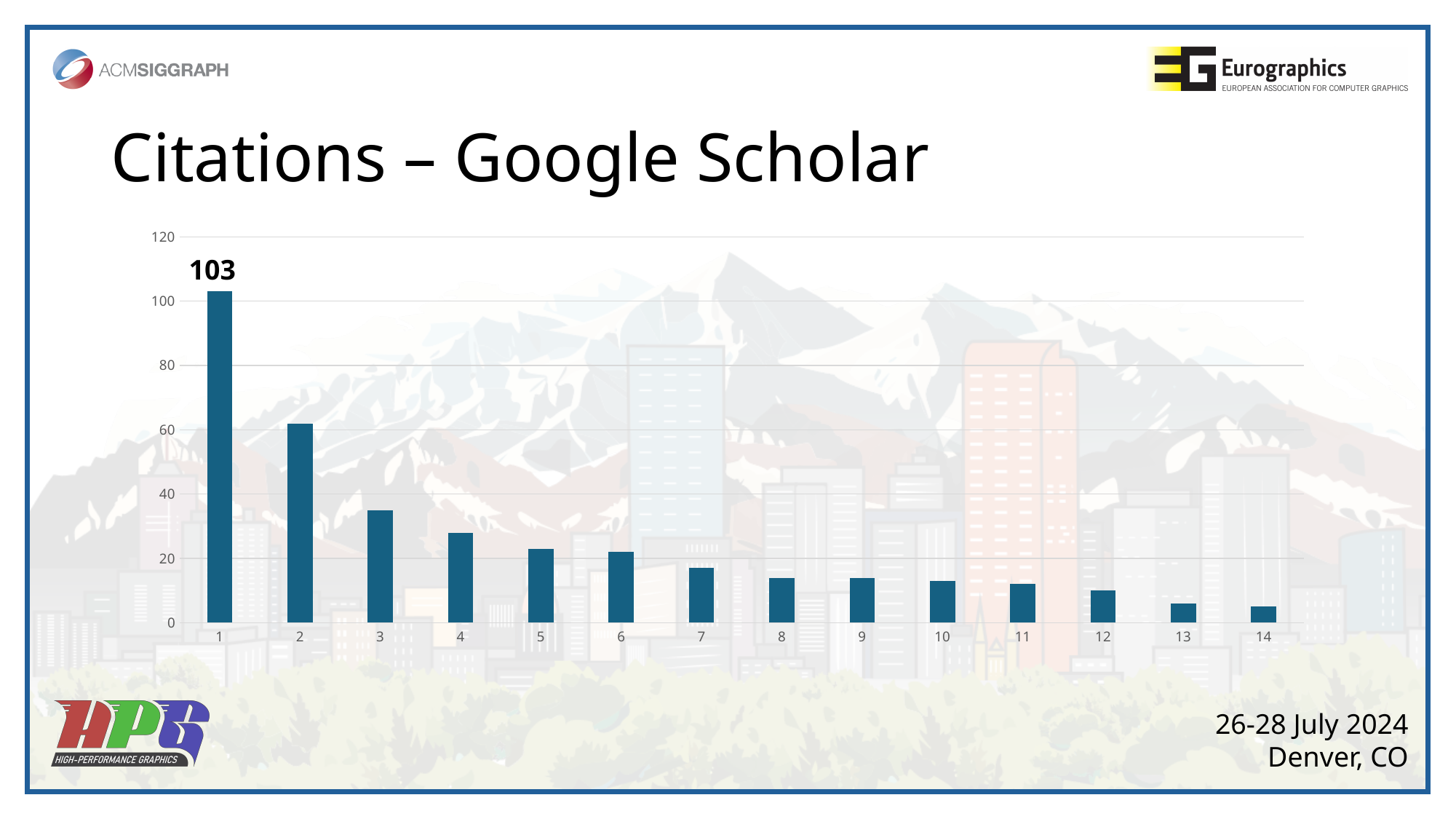
How many categories are shown on the x axis? 14 Do the values rise or fall as you move from category 1 to category 14? fall Is the value for category 7 greater or less than 20? less Which has the larger value, category 2 or category 3? 2 Which category has the highest value? 1 Which has the larger value, category 4 or category 8? 4 What kind of chart is shown on the slide? bar chart What is the value shown for category 1? 103 Is the value for category 4 greater or less than 20? greater What is the title of the slide containing the chart? Citations – Google Scholar Is the value for category 3 greater or less than 40? less